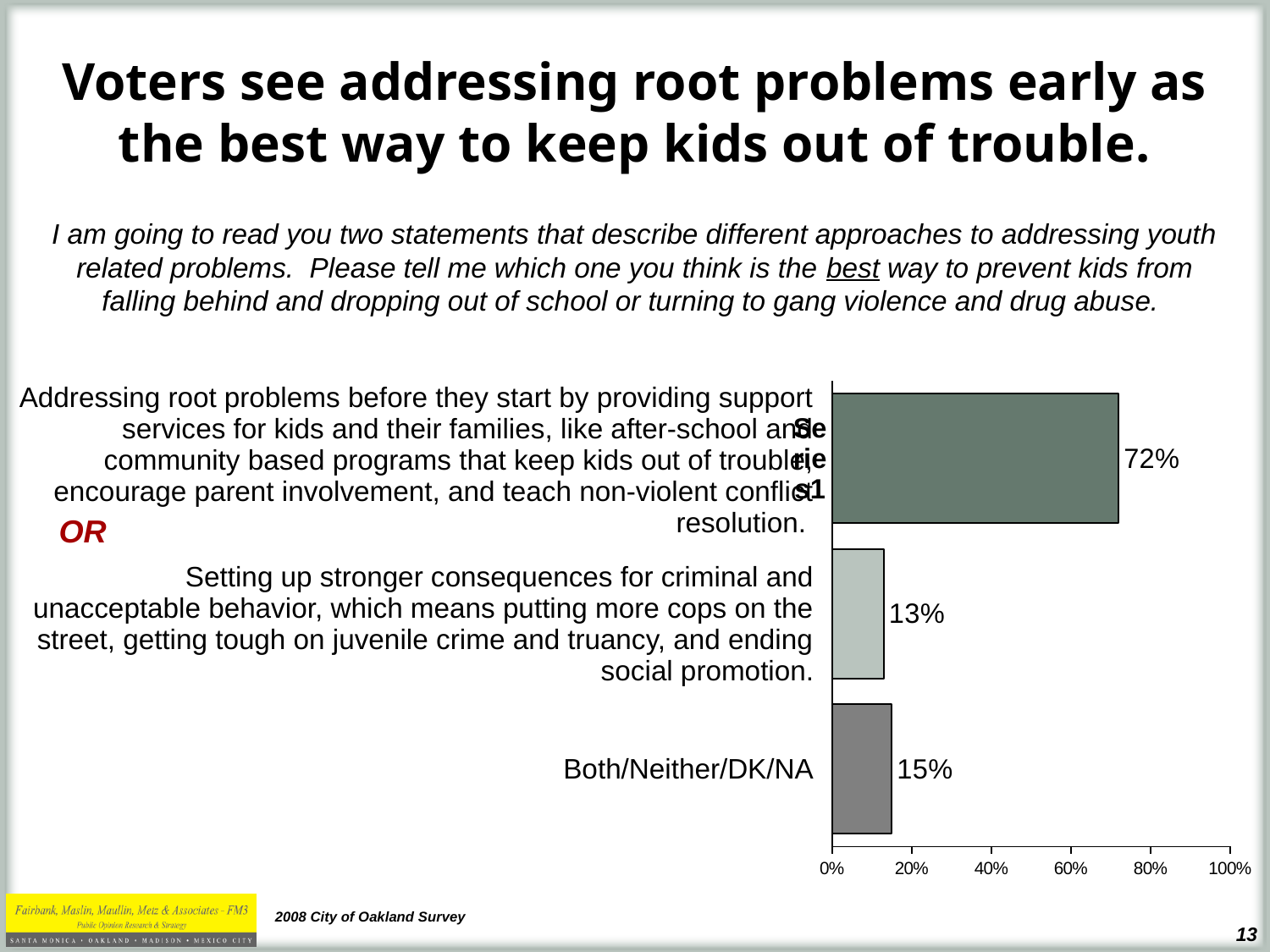
Is the value for addressing root problems greater or less than 60%? greater Which is larger: the share for Both/Neither/DK/NA or the share for setting up stronger consequences? Both/Neither/DK/NA Which response option has the highest percentage? Addressing root problems before they start What percentage of voters chose setting up stronger consequences for criminal and unacceptable behavior? 13% What is the difference in percentage points between addressing root problems and setting up stronger consequences? 59 Is the value for Both/Neither/DK/NA greater or less than 20%? less What percentage of voters chose addressing root problems before they start as the best approach? 72% How many response categories are shown in the chart? 3 What is the maximum value shown on the horizontal axis of the chart? 100% What kind of chart is shown on the slide? Bar chart What percentage of voters answered Both/Neither/DK/NA? 15% Which response option has the lowest percentage? Setting up stronger consequences for criminal and unacceptable behavior